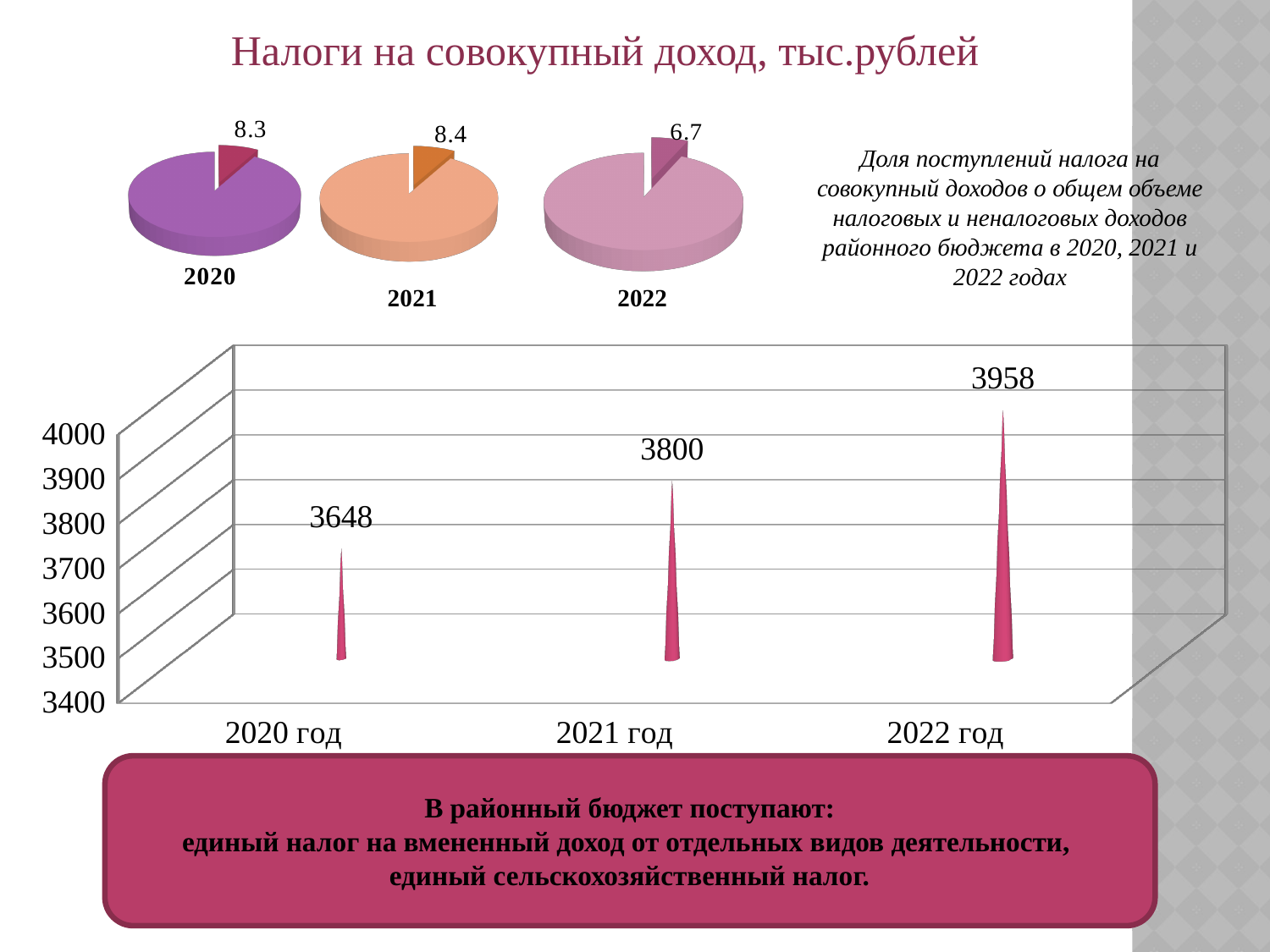
In the lower bar chart, which year has the lowest value? 2020 год In the lower bar chart, what is the difference between the values for 2022 год and 2020 год? 310 What kind of chart is the lower chart on the slide? bar chart In the lower bar chart, which year has the highest value? 2022 год In the lower bar chart, what is the difference between the values for 2021 год and 2020 год? 152 How many categories are shown in the lower bar chart? 3 In the lower bar chart, do the values rise or fall from 2020 год to 2022 год? rise In the lower bar chart, what is the value for 2022 год? 3958 In the lower bar chart, what is the value for 2020 год? 3648 In the lower bar chart, what is the value for 2021 год? 3800 In the upper pie chart labelled 2021, what value is shown for the exploded slice? 8.4 In the upper pie chart labelled 2022, what value is shown for the exploded slice? 6.7